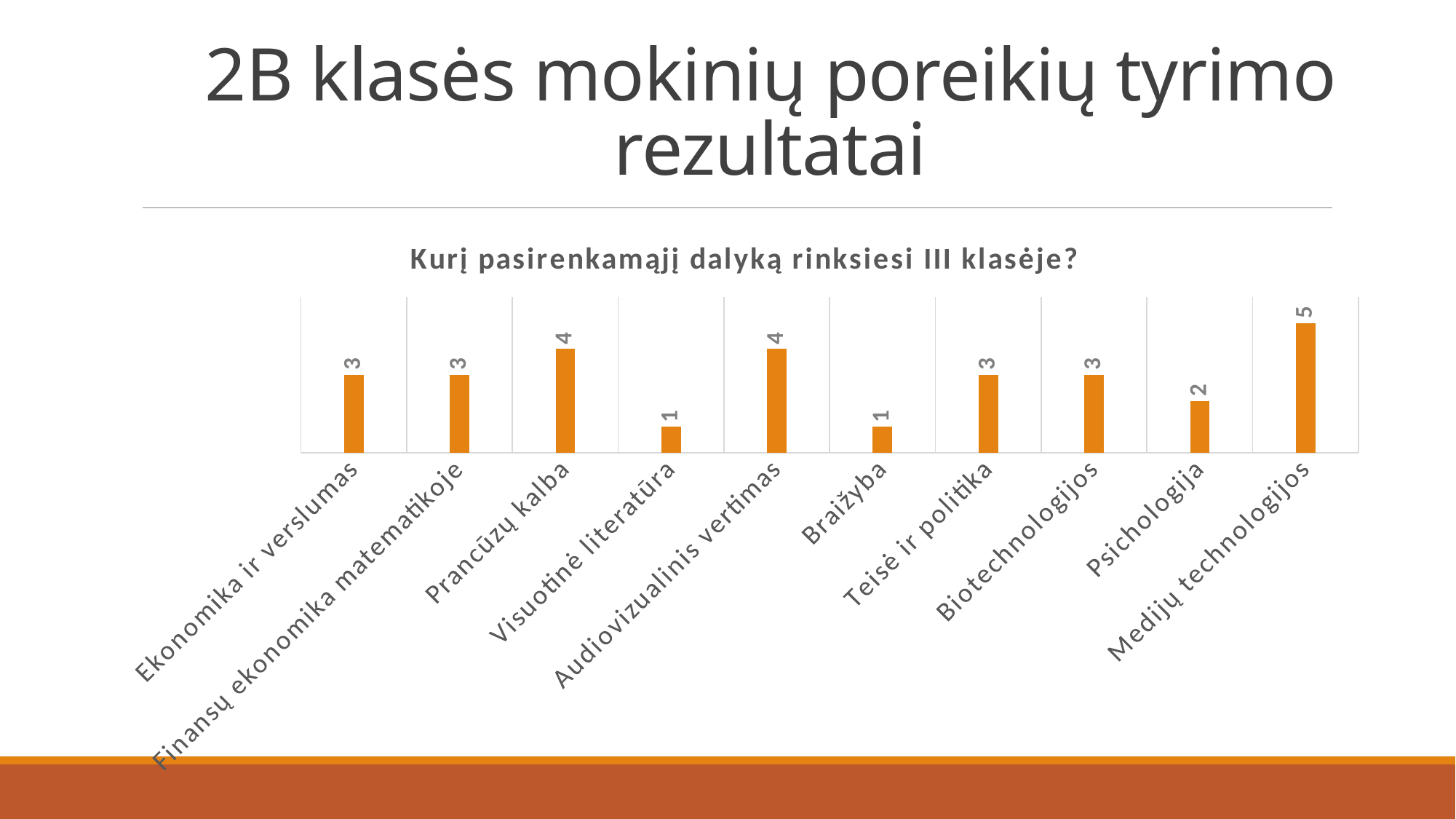
What is the difference between the values for Medijų technologijos and Psichologija? 3 What is the title of the chart? Kurį pasirenkamąjį dalyką rinksiesi III klasėje? Which is larger, the value for Audiovizualinis vertimas or the value for Teisė ir politika? Audiovizualinis vertimas Which category has the highest value? Medijų technologijos What is the value for Prancūzų kalba? 4 What is the value for Braižyba? 1 What colour are the bars in the chart? orange What kind of chart is shown on the slide? bar chart What is the difference between the values for Prancūzų kalba and Visuotinė literatūra? 3 How many categories are shown on the x axis? 10 What is the value for Medijų technologijos? 5 What is the value for Psichologija? 2